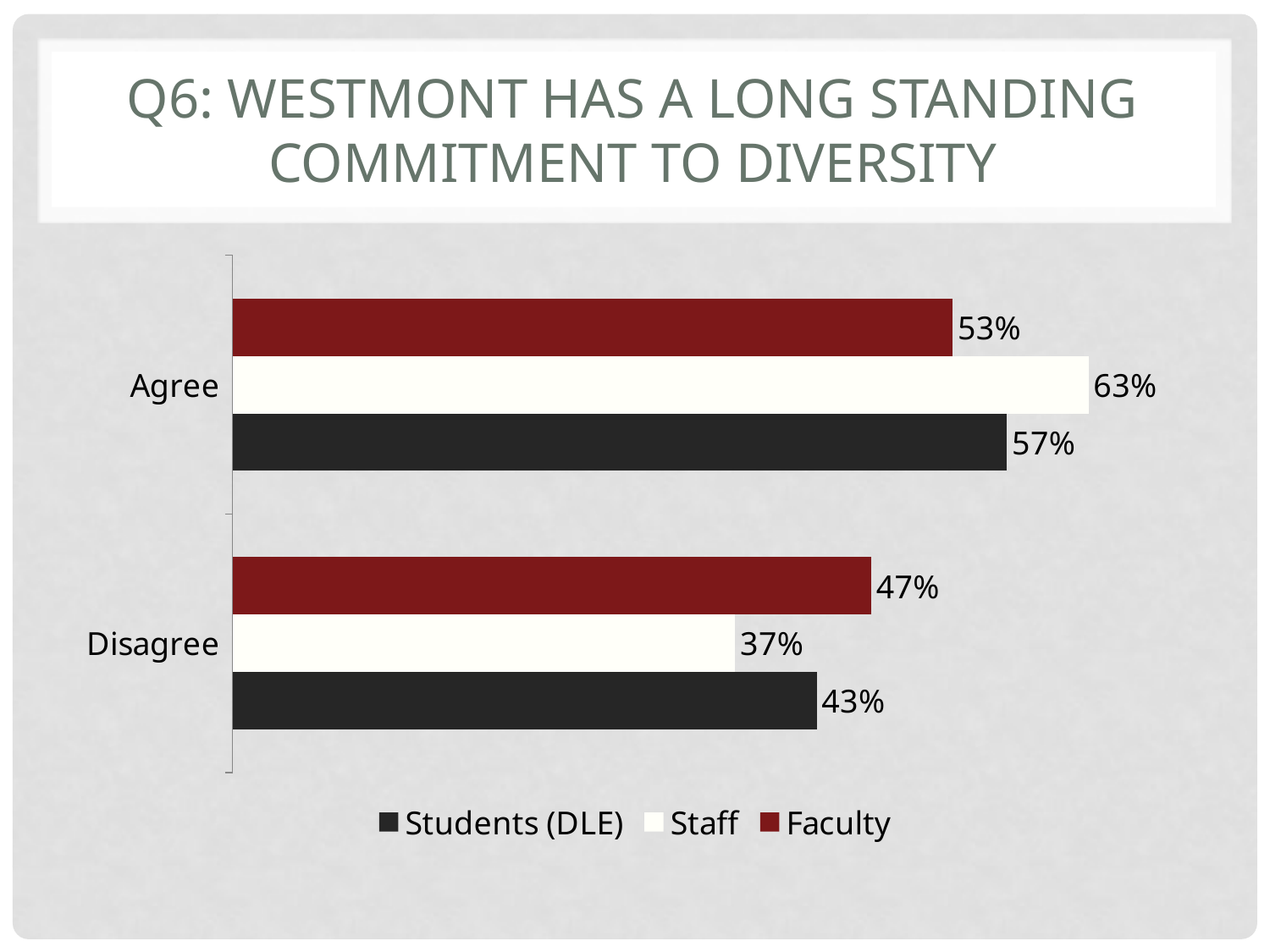
Which group has the highest percentage in the Agree category? Staff Which group has the lowest percentage in the Disagree category? Staff What is the title of the chart? Q6: Westmont has a long standing commitment to diversity What percentage of Faculty disagree? 47% How many series does the legend list? 3 What is the difference between the Staff Agree percentage and the Faculty Agree percentage? 10% Which series is shown in dark red? Faculty What percentage of Staff agree that Westmont has a long standing commitment to diversity? 63% Which is larger: the Students (DLE) Disagree percentage or the Faculty Disagree percentage? Faculty What kind of chart is shown on the slide? Bar chart What percentage of Students (DLE) agree? 57% How many response categories are shown on the chart? 2